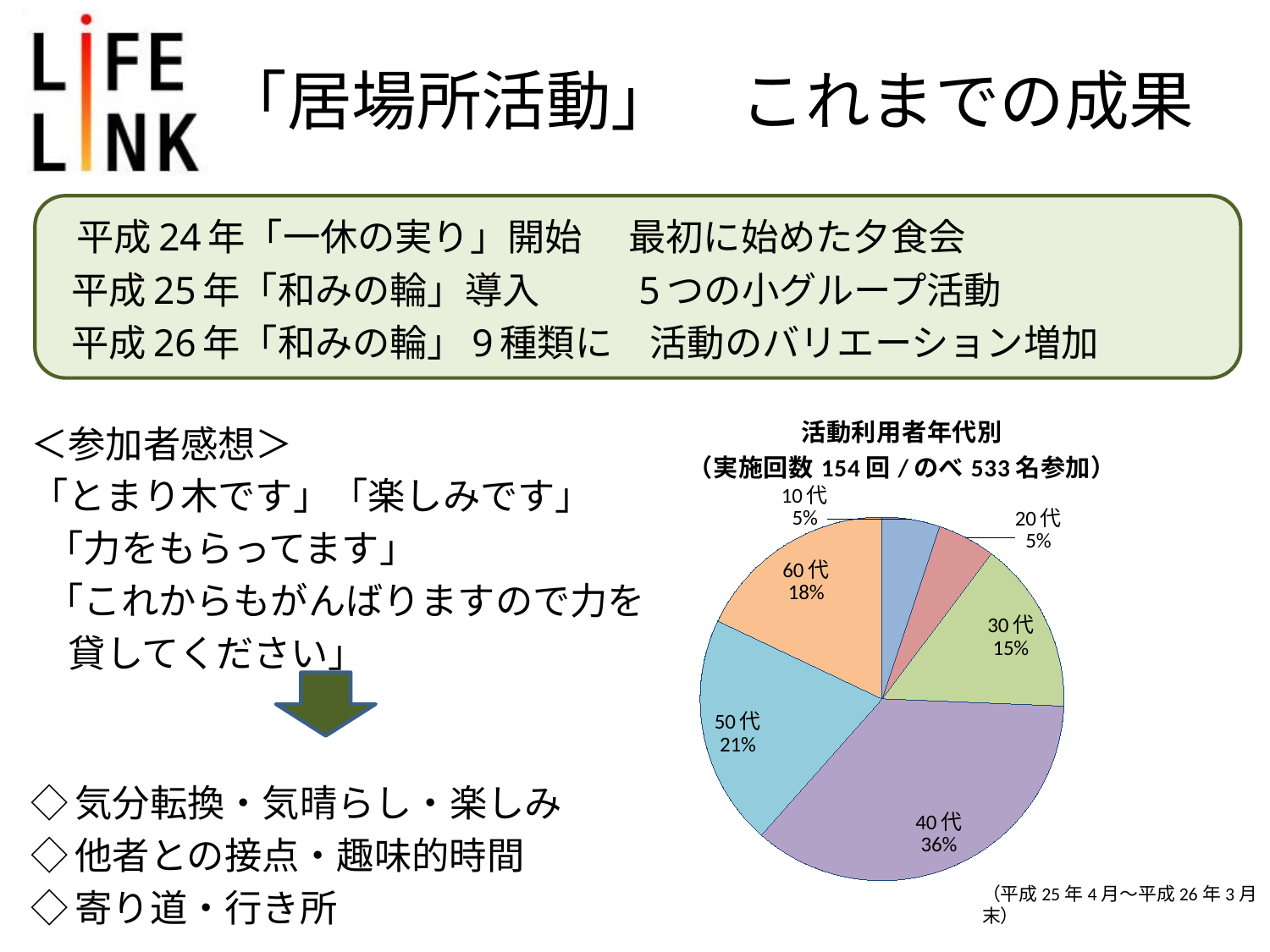
Which is larger, the share for 50代 or the share for 60代? 50代 What is the value shown for 10代? 5% What is the value shown for 30代? 15% What is the difference in percentage points between the 40代 share and the 50代 share? 15 How many age-group slices does the pie chart have? 6 What is the value shown for 60代? 18% What share of the pie does 40代 account for? 36% What is the combined share of 40代 and 50代? 57% What kind of chart is shown on the slide? pie chart What is the title of the pie chart? 活動利用者年代別（実施回数154回／のべ533名参加） What is the value shown for 50代? 21% Which age group has the largest slice of the pie? 40代